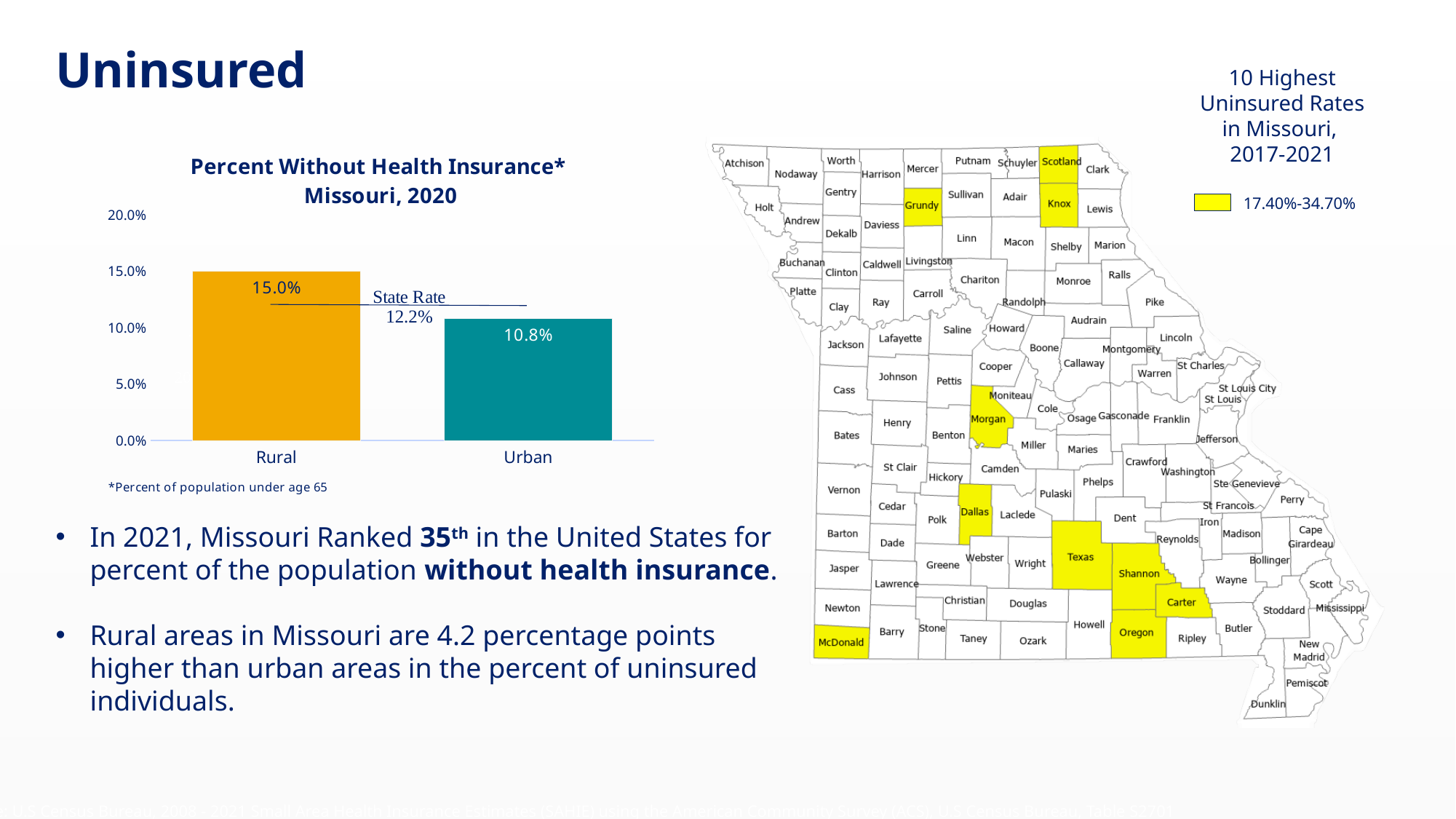
In the 'Percent Without Health Insurance* Missouri, 2020' chart, what is the difference between the Rural and Urban values? 4.2 percentage points How many categories are shown in the 'Percent Without Health Insurance* Missouri, 2020' chart? 2 What range of uninsured rates does the yellow shading on the Missouri map represent? 17.40%-34.70% In the 'Percent Without Health Insurance* Missouri, 2020' chart, which category has the highest value? Rural What is the highest value shown on the y-axis of the 'Percent Without Health Insurance* Missouri, 2020' chart? 20.0% In the 'Percent Without Health Insurance* Missouri, 2020' chart, is the value for Rural or Urban larger? Rural In the 'Percent Without Health Insurance* Missouri, 2020' chart, what is the value for Rural? 15.0% In the 'Percent Without Health Insurance* Missouri, 2020' chart, what is the value for Urban? 10.8% What State Rate is marked on the 'Percent Without Health Insurance* Missouri, 2020' chart? 12.2% What kind of chart is 'Percent Without Health Insurance* Missouri, 2020'? Bar chart In the 'Percent Without Health Insurance* Missouri, 2020' chart, which category has the lowest value? Urban In the 'Percent Without Health Insurance* Missouri, 2020' chart, is the value for Urban greater or less than 15.0%? less